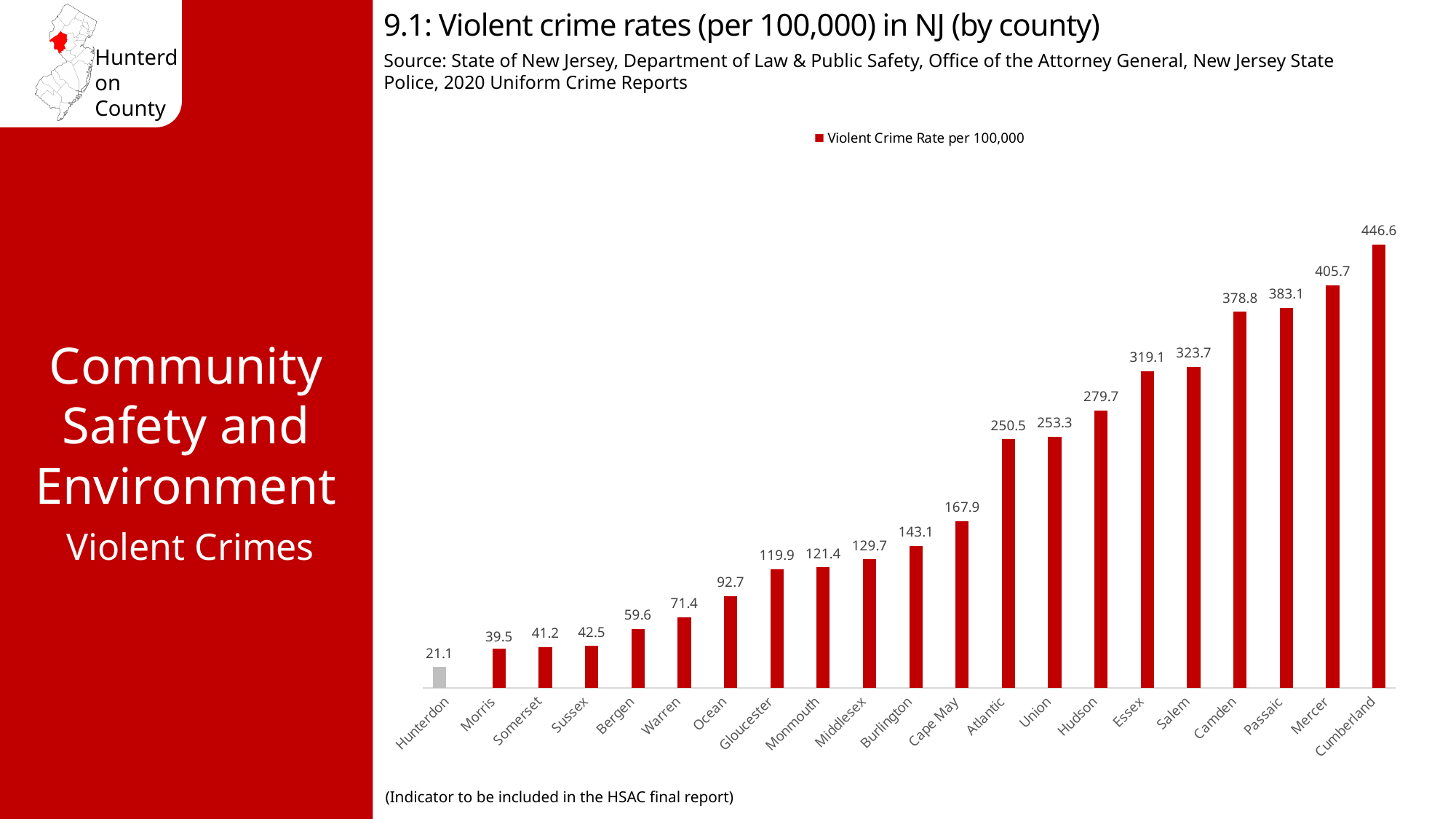
What is the difference between the violent crime rates of Essex and Hudson counties? 39.4 What is the difference between the violent crime rates of Cumberland and Hunterdon counties? 425.5 How many series does the legend list? 1 What is the violent crime rate per 100,000 for Hunterdon County? 21.1 Do the values rise or fall from left to right along the x axis? Rise What is the violent crime rate per 100,000 for Hudson County? 279.7 Which county has the highest violent crime rate? Cumberland What is the violent crime rate per 100,000 for Cape May County? 167.9 What kind of chart is shown on the slide? Bar chart How many counties are shown on the chart? 21 Which county has the lowest violent crime rate? Hunterdon Which county has a higher violent crime rate, Mercer or Camden? Mercer